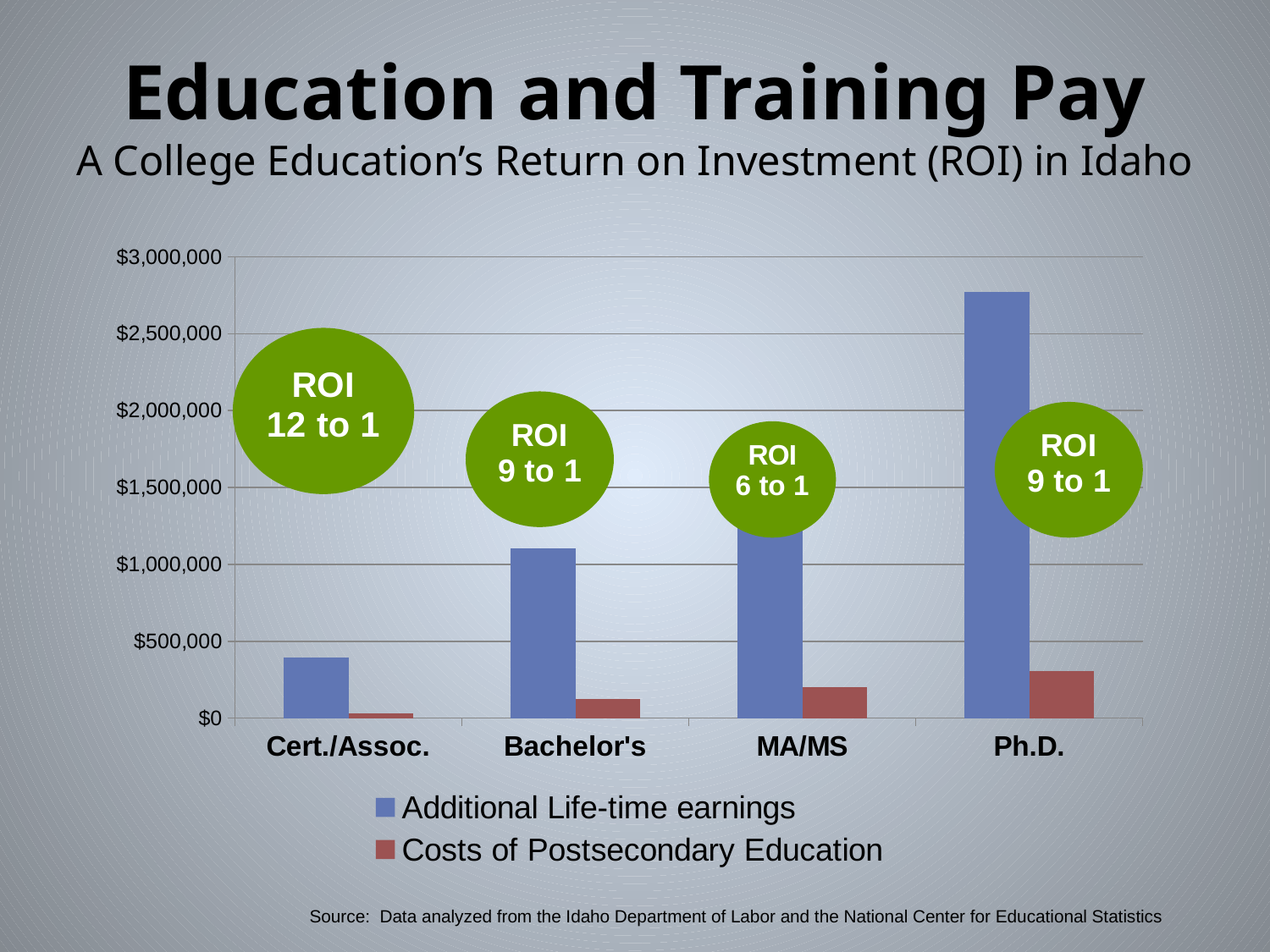
How many series does the legend list? 2 Do the Additional Life-time earnings rise or fall moving from Cert./Assoc. to Ph.D. along the x axis? Rise How many education levels are shown on the x axis? 4 Is the Additional Life-time earnings value for Ph.D. greater or less than $2,500,000? greater Is the Additional Life-time earnings value for Bachelor's greater or less than $1,000,000? greater What ROI is shown in the circle above the Cert./Assoc. bars? 12 to 1 Which education level has the lowest Additional Life-time earnings? Cert./Assoc. Which education level has the highest Costs of Postsecondary Education? Ph.D. Which education level has the highest Additional Life-time earnings? Ph.D. Is the Additional Life-time earnings value for Cert./Assoc. greater or less than $500,000? less Which is larger: Additional Life-time earnings for Ph.D. or for MA/MS? Ph.D. What type of chart is shown on the slide? Bar chart